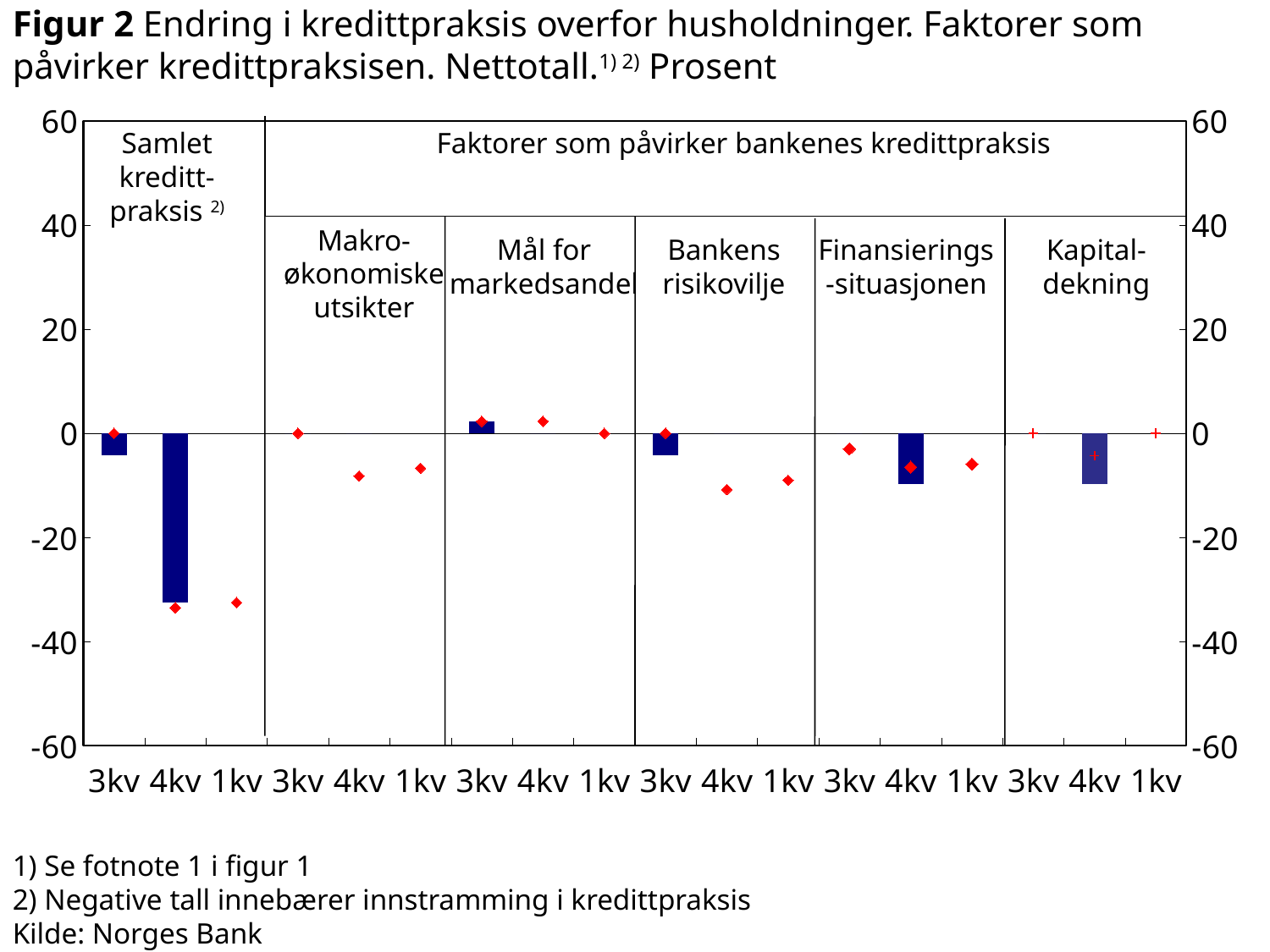
What source is cited for the chart? Norges Bank What is the maximum value shown on the y axis? 60 In the 'Samlet kredittpraksis' panel, does the bar value rise or fall from 3kv to 4kv? fall What kind of chart is shown in Figur 2? combination bar and line chart Is the 4kv bar for 'Kapitaldekning' greater or less than -20? greater Is the 4kv bar for 'Samlet kredittpraksis' greater or less than -20? less Which panel has a positive bar in 3kv? Mål for markedsandel Which panel contains the lowest bar in the chart? Samlet kredittpraksis How many factor panels are shown under 'Faktorer som påvirker bankenes kredittpraksis'? 5 Which is lower, the 4kv bar for 'Samlet kredittpraksis' or the 4kv bar for 'Kapitaldekning'? Samlet kredittpraksis Is the 4kv bar for 'Samlet kredittpraksis' greater or less than -40? greater How many quarters are shown on the x axis within each panel? 3